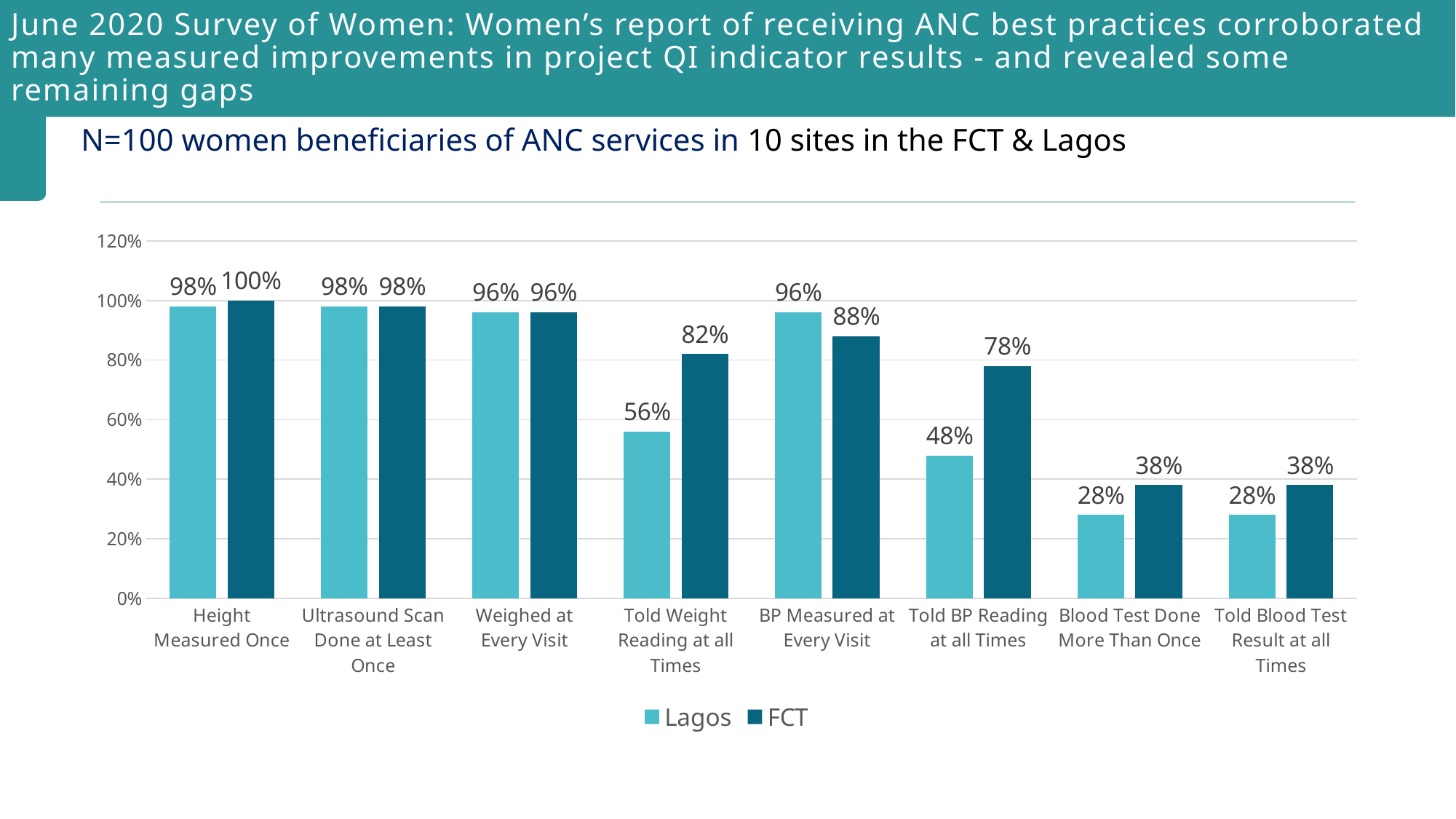
What is the Lagos value for Told BP Reading at all Times? 48% How many categories are shown on the x axis? 8 What is the difference between the FCT and Lagos values for Told BP Reading at all Times? 30% Which series is shown in the darker blue colour? FCT What is the Lagos value for BP Measured at Every Visit? 96% Which category has the lowest Lagos value? Blood Test Done More Than Once and Told Blood Test Result at all Times (both 28%) How many series does the legend list? 2 What kind of chart is shown on the slide? Bar chart Which category has the highest FCT value? Height Measured Once Is the Lagos value for Told Weight Reading at all Times greater or less than 60%? less Which is larger for Told Weight Reading at all Times, the Lagos value or the FCT value? FCT What is the FCT value for Told Weight Reading at all Times? 82%